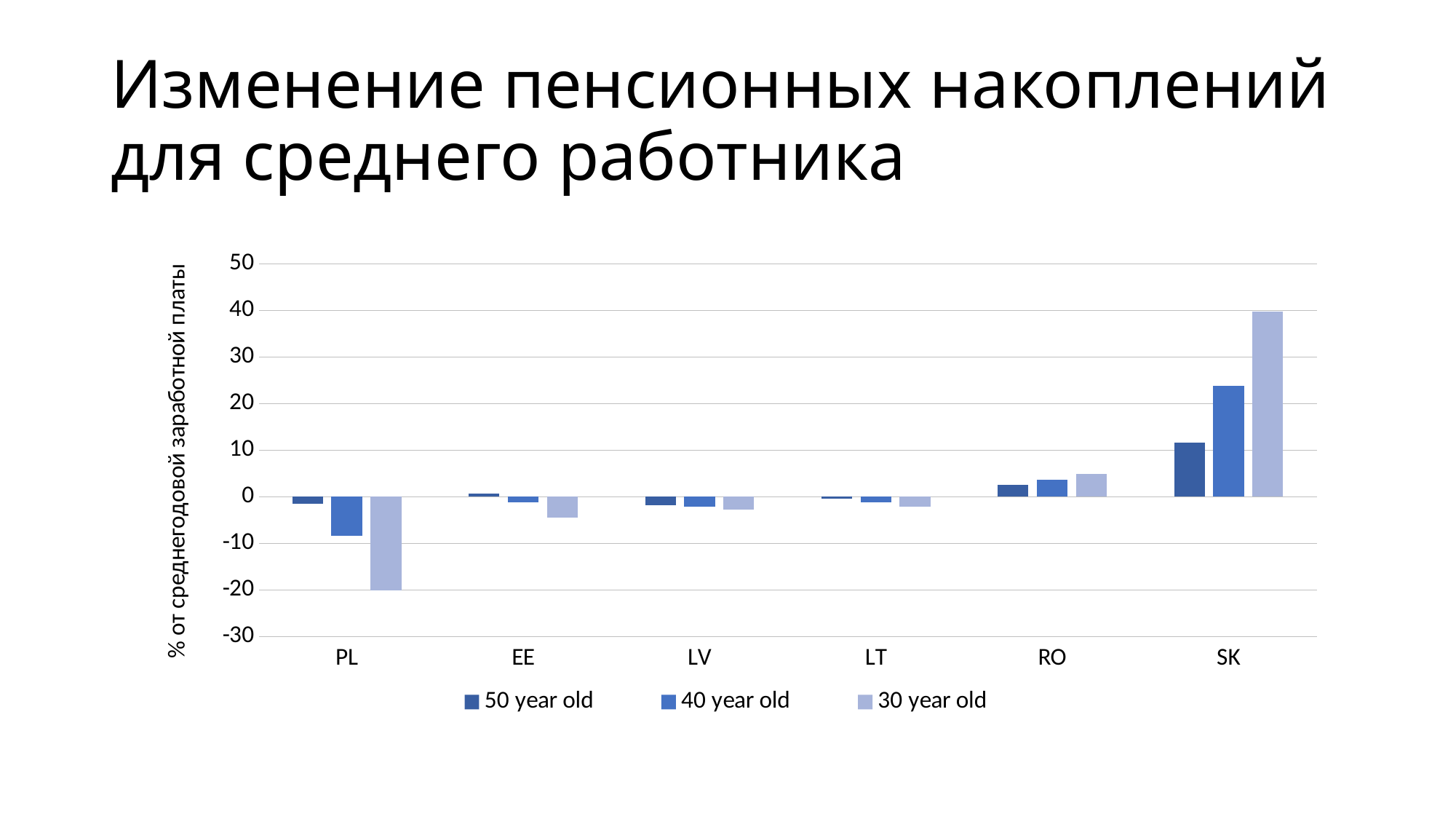
Is the value for SK in the 40 year old series greater or less than 20? greater What is the label on the vertical axis? % от среднегодовой заработной платы Which country has the highest value for the 40 year old series? SK Which is larger for the 50 year old series: SK or RO? SK Is the value for PL in the 30 year old series greater or less than -10? less What kind of chart is shown on the slide? bar chart How many series does the legend list? 3 Which country has the lowest value for the 30 year old series? PL Which country has the highest value for the 30 year old series? SK How many countries are shown on the x axis? 6 What are the three series listed in the legend? 50 year old, 40 year old, 30 year old Is the value for SK in the 30 year old series greater or less than 30? greater